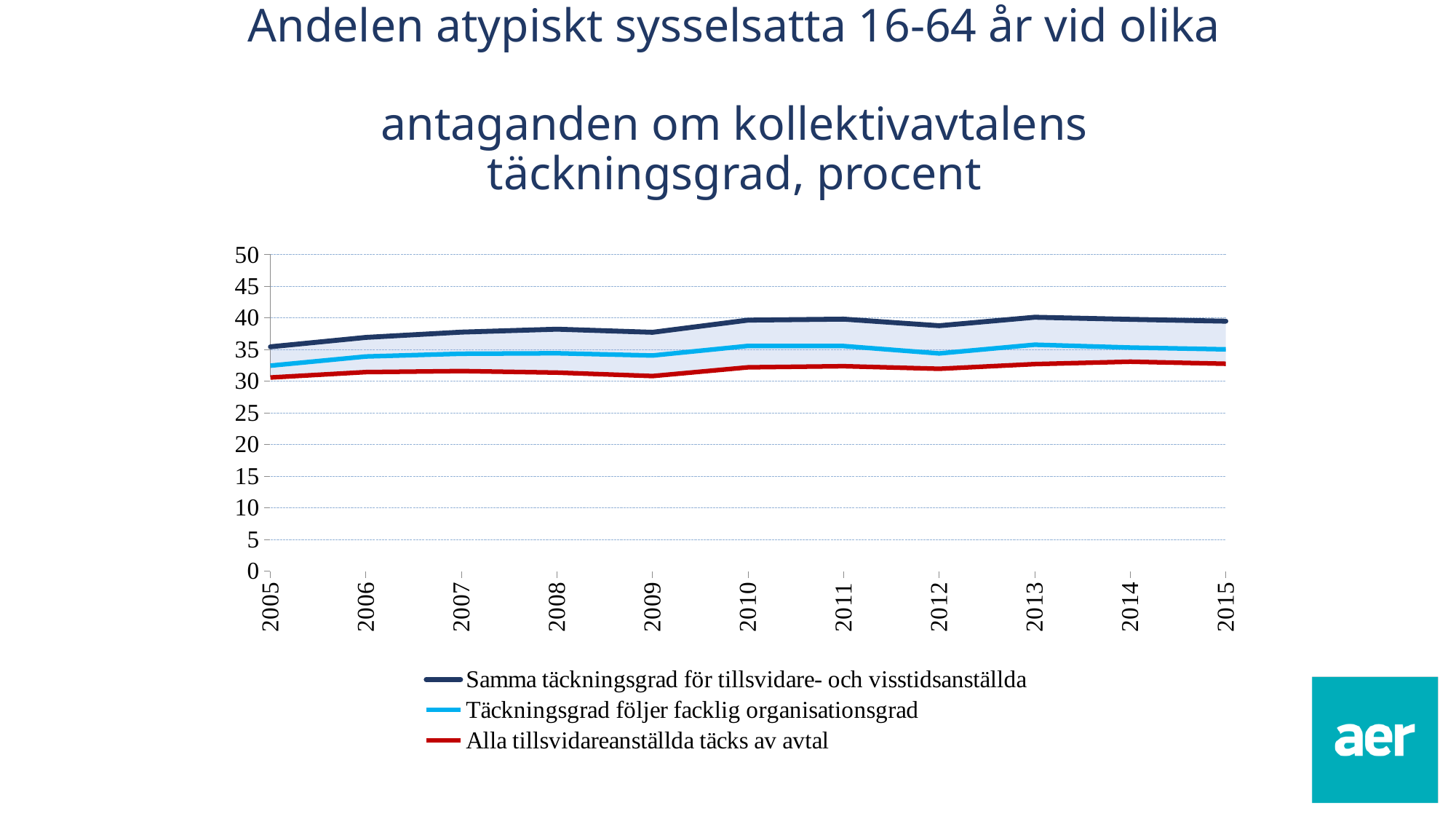
Which series has the highest values throughout the chart? Samma täckningsgrad för tillsvidare- och visstidsanställda In which year is the value for 'Samma täckningsgrad för tillsvidare- och visstidsanställda' lowest? 2005 Which series is drawn in red? Alla tillsvidareanställda täcks av avtal What kind of chart is shown on the slide? line chart Is the value for 'Täckningsgrad följer facklig organisationsgrad' in 2005 greater or less than 30? greater For 'Samma täckningsgrad för tillsvidare- och visstidsanställda', is the value in 2015 larger or smaller than in 2005? larger Do the values for 'Alla tillsvidareanställda täcks av avtal' generally rise or fall from 2005 to 2015? rise Which series has the lowest values throughout the chart? Alla tillsvidareanställda täcks av avtal How many years are plotted along the x axis? 11 How many series does the legend list? 3 Is the value for 'Alla tillsvidareanställda täcks av avtal' in 2014 greater or less than 35? less Is the value for 'Samma täckningsgrad för tillsvidare- och visstidsanställda' in 2009 greater or less than 40? less